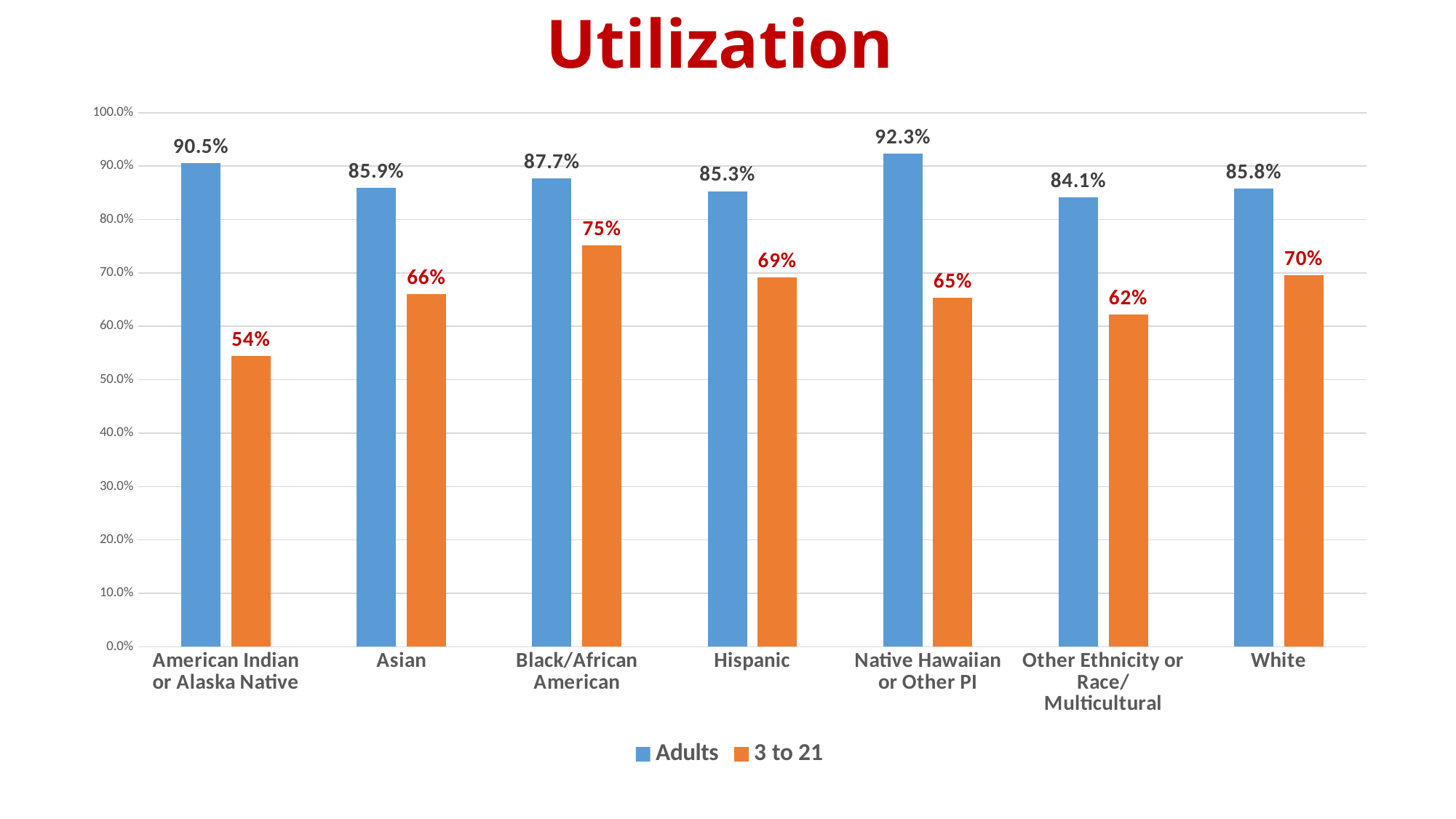
What kind of chart is shown on the slide? Bar chart What is the Adults value for Other Ethnicity or Race/Multicultural? 84.1% Which category has the lowest 3 to 21 value? American Indian or Alaska Native What is the Adults value for Native Hawaiian or Other PI? 92.3% What is the title of the chart? Utilization How many series does the legend list? 2 Which is larger, the 3 to 21 value for Hispanic or the 3 to 21 value for Asian? Hispanic What is the difference between the Adults value and the 3 to 21 value for White? 15.8% What is the 3 to 21 value for Black/African American? 75% What is the 3 to 21 value for American Indian or Alaska Native? 54% Which category has the highest Adults value? Native Hawaiian or Other PI How many categories are shown on the x axis? 7